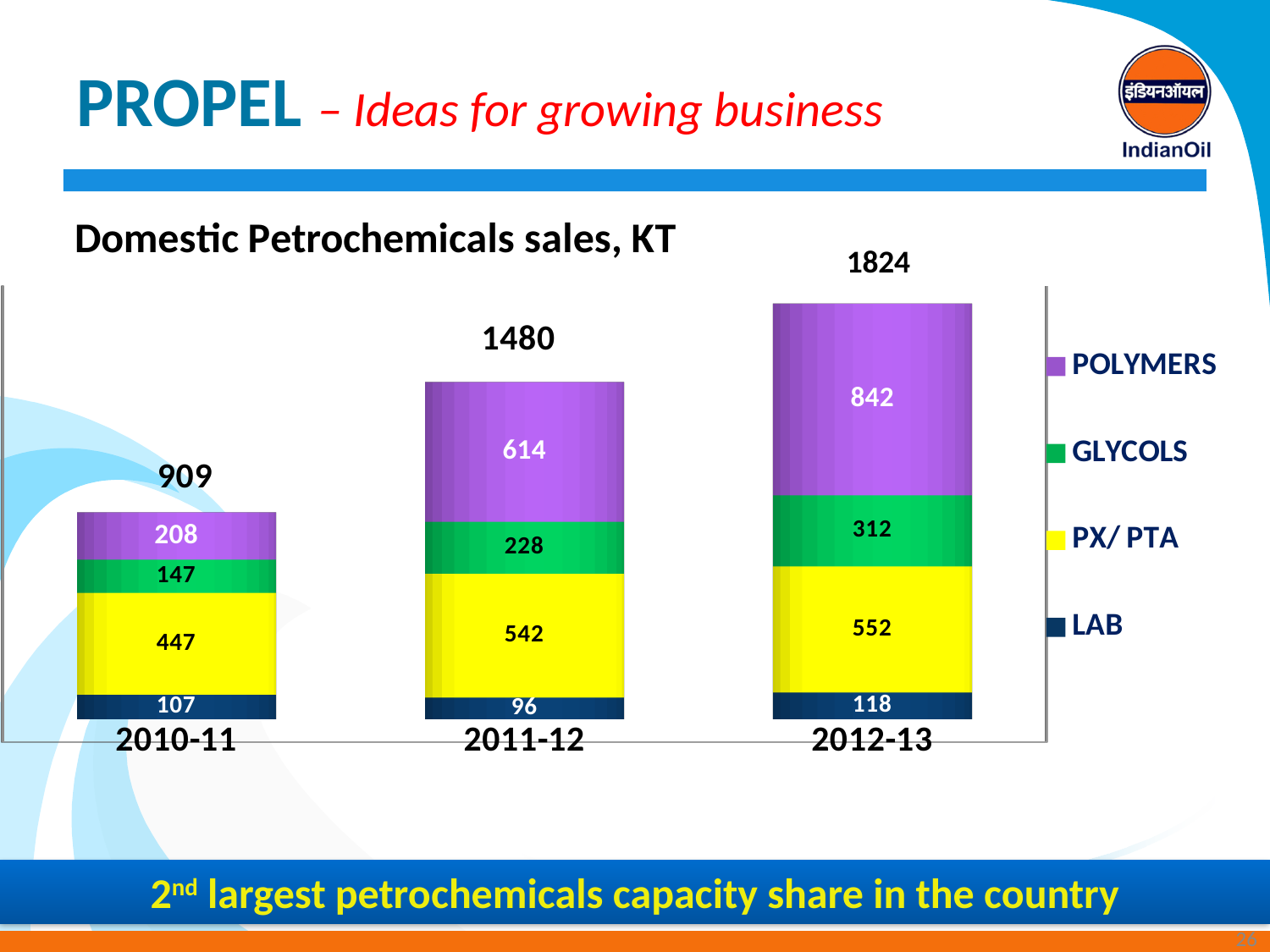
Which is larger, the GLYCOLS value for 2012-13 or the POLYMERS value for 2010-11? GLYCOLS value for 2012-13 How many series does the legend list? 4 Which year has the lowest LAB value? 2011-12 What is the POLYMERS value for 2012-13? 842 What is the PX/ PTA value for 2011-12? 542 What is the total of the stacked bar for 2010-11? 909 What is the GLYCOLS value for 2011-12? 228 What is the total of the stacked bar for 2012-13? 1824 Which year has the highest total domestic petrochemicals sales? 2012-13 Do the total sales rise or fall from 2010-11 to 2012-13? rise What is the difference between the POLYMERS values for 2012-13 and 2011-12? 228 What is the LAB value for 2010-11? 107